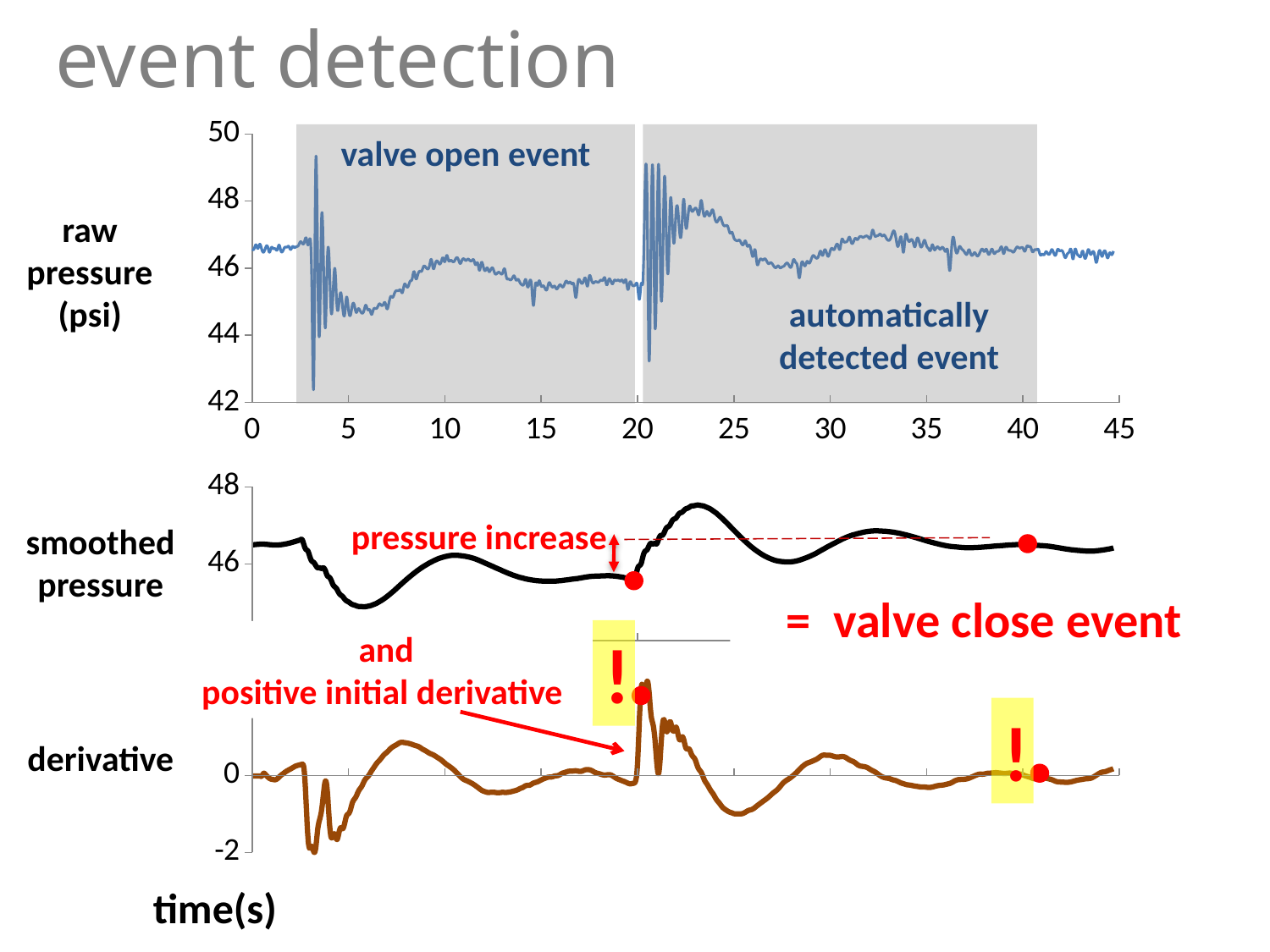
What label is given to the shared x axis at the bottom of the slide? time(s) In the raw pressure chart, is the value at around 6 seconds greater or less than 46? less What is the largest tick value shown on the x axis of the raw pressure chart? 45 In the raw pressure chart, does the pressure rise or fall between 5 and 10 seconds? rise What is the title of the slide containing the pressure charts? event detection In the smoothed pressure chart, is the peak value near 23 seconds greater or less than 48? less In the smoothed pressure chart, does the pressure rise or fall between 3 and 6 seconds? fall In the raw pressure chart, is the value at time 0 greater or less than 46? greater What kind of chart is the raw pressure chart at the top of the slide? line chart